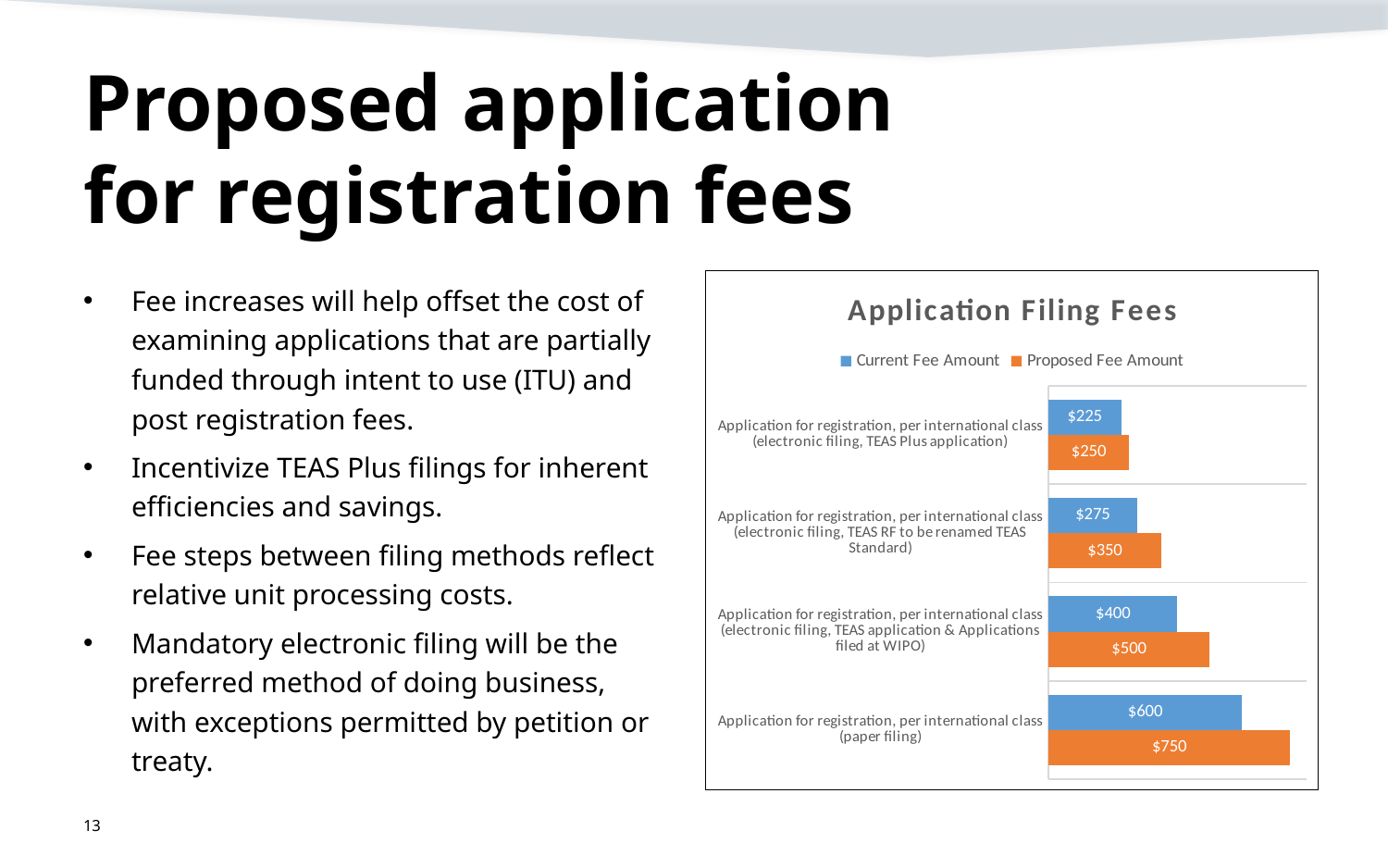
What is the Current Fee Amount for Application for registration, per international class (electronic filing, TEAS application & Applications filed at WIPO)? $400 What is the difference between the Proposed Fee Amount and the Current Fee Amount for Application for registration, per international class (electronic filing, TEAS application & Applications filed at WIPO)? $100 What type of chart is the Application Filing Fees chart? Bar chart Which category has the highest Proposed Fee Amount? Application for registration, per international class (paper filing) Which category has the lowest Current Fee Amount? Application for registration, per international class (electronic filing, TEAS Plus application) What is the difference between the Proposed Fee Amount and the Current Fee Amount for Application for registration, per international class (paper filing)? $150 What is the Proposed Fee Amount for Application for registration, per international class (paper filing)? $750 Which is larger: the Current Fee Amount for paper filing or the Proposed Fee Amount for electronic filing, TEAS application & Applications filed at WIPO? Current Fee Amount for paper filing How many series does the legend of the Application Filing Fees chart list? 2 What is the Current Fee Amount for Application for registration, per international class (electronic filing, TEAS Plus application)? $225 How many categories are shown in the Application Filing Fees chart? 4 What is the Proposed Fee Amount for Application for registration, per international class (electronic filing, TEAS RF to be renamed TEAS Standard)? $350